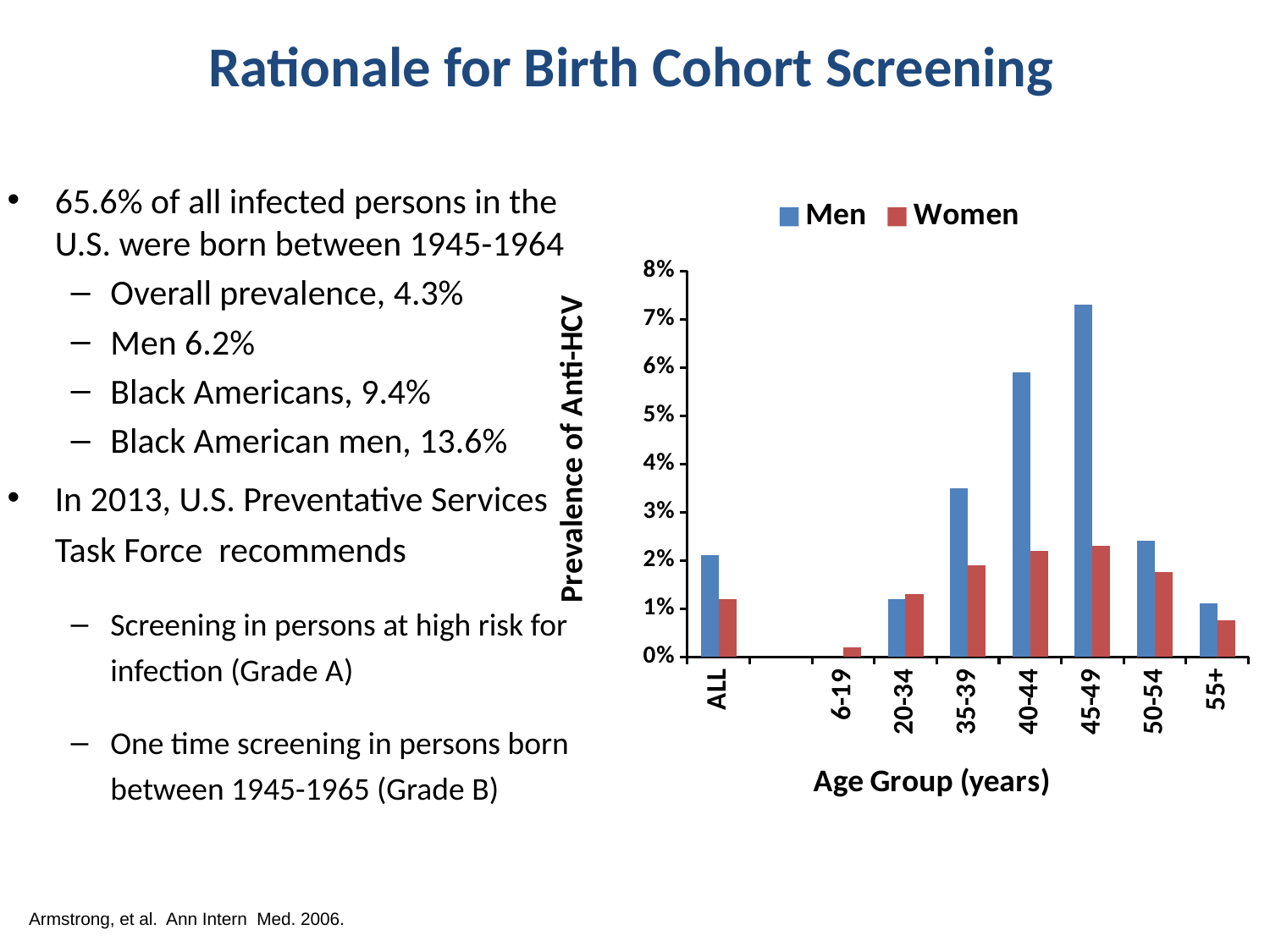
How many age group categories are shown on the x axis of the chart? 8 Is the value for Women in the 6-19 age group greater or less than 1%? less What kind of chart is shown on the slide? bar chart In the 40-44 age group, which is larger, the value for Men or the value for Women? Men Which age group has the highest prevalence of anti-HCV for Men? 45-49 Is the value for Men in the 35-39 age group greater or less than 3%? greater How many series does the chart legend list? 2 What is the label of the y axis of the chart? Prevalence of Anti-HCV Which age group has the highest prevalence of anti-HCV for Women? 45-49 Is the value for Men in the 45-49 age group greater or less than 7%? greater Do the values for Men rise or fall from the 20-34 age group to the 45-49 age group? rise